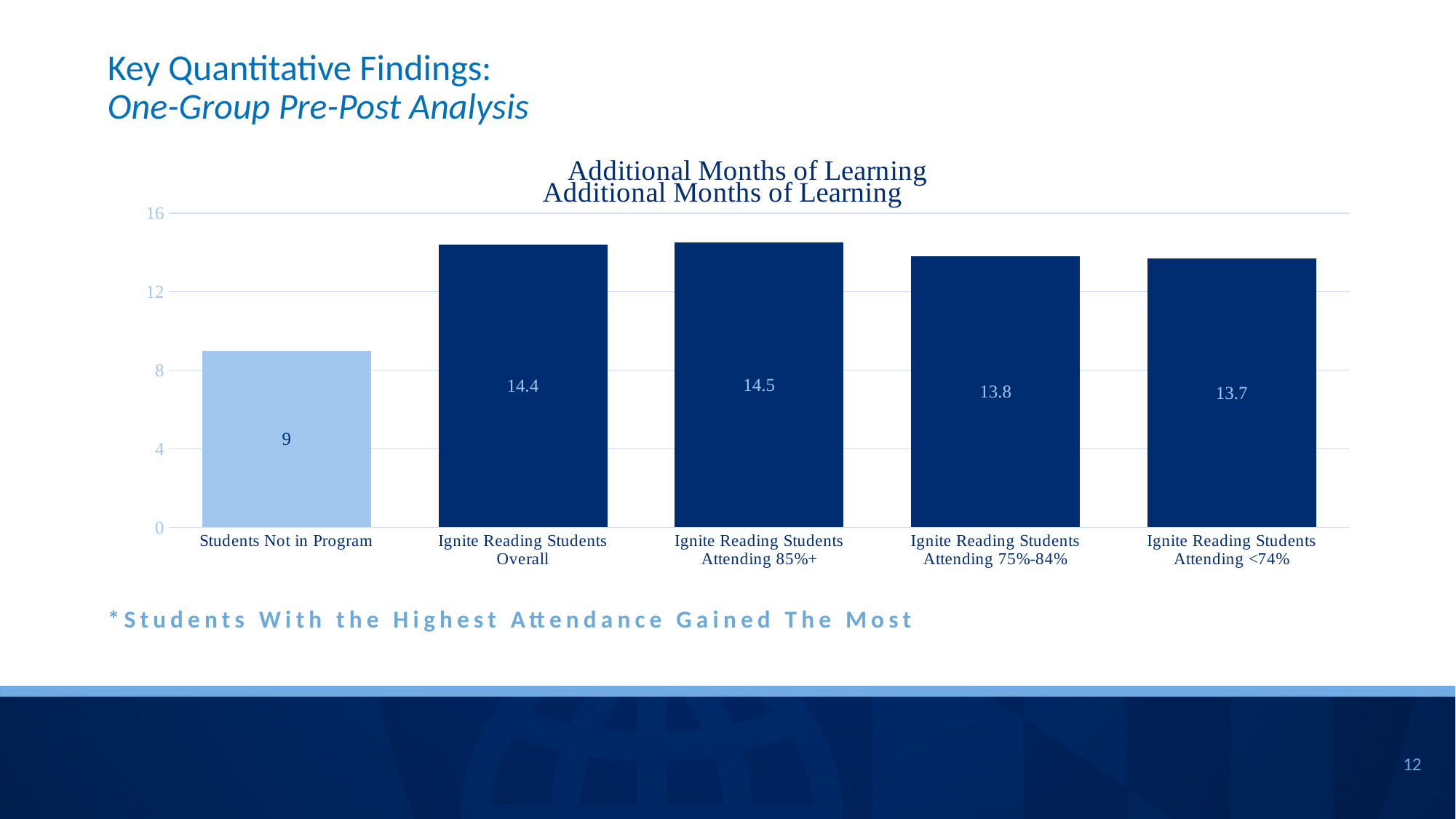
What is the title of the chart? Additional Months of Learning Which category has the lowest value? Students Not in Program What is the value for Ignite Reading Students Overall? 14.4 What is the difference between Ignite Reading Students Attending 85%+ and Students Not in Program? 5.5 How many categories are shown in the chart? 5 What is the difference between Ignite Reading Students Overall and Ignite Reading Students Attending <74%? 0.7 What is the value for Students Not in Program? 9 What is the value for Ignite Reading Students Attending 85%+? 14.5 What kind of chart is shown on the slide? Bar chart Which is larger, the value for Ignite Reading Students Overall or the value for Students Not in Program? Ignite Reading Students Overall What is the value for Ignite Reading Students Attending 75%-84%? 13.8 What is the value for Ignite Reading Students Attending <74%? 13.7